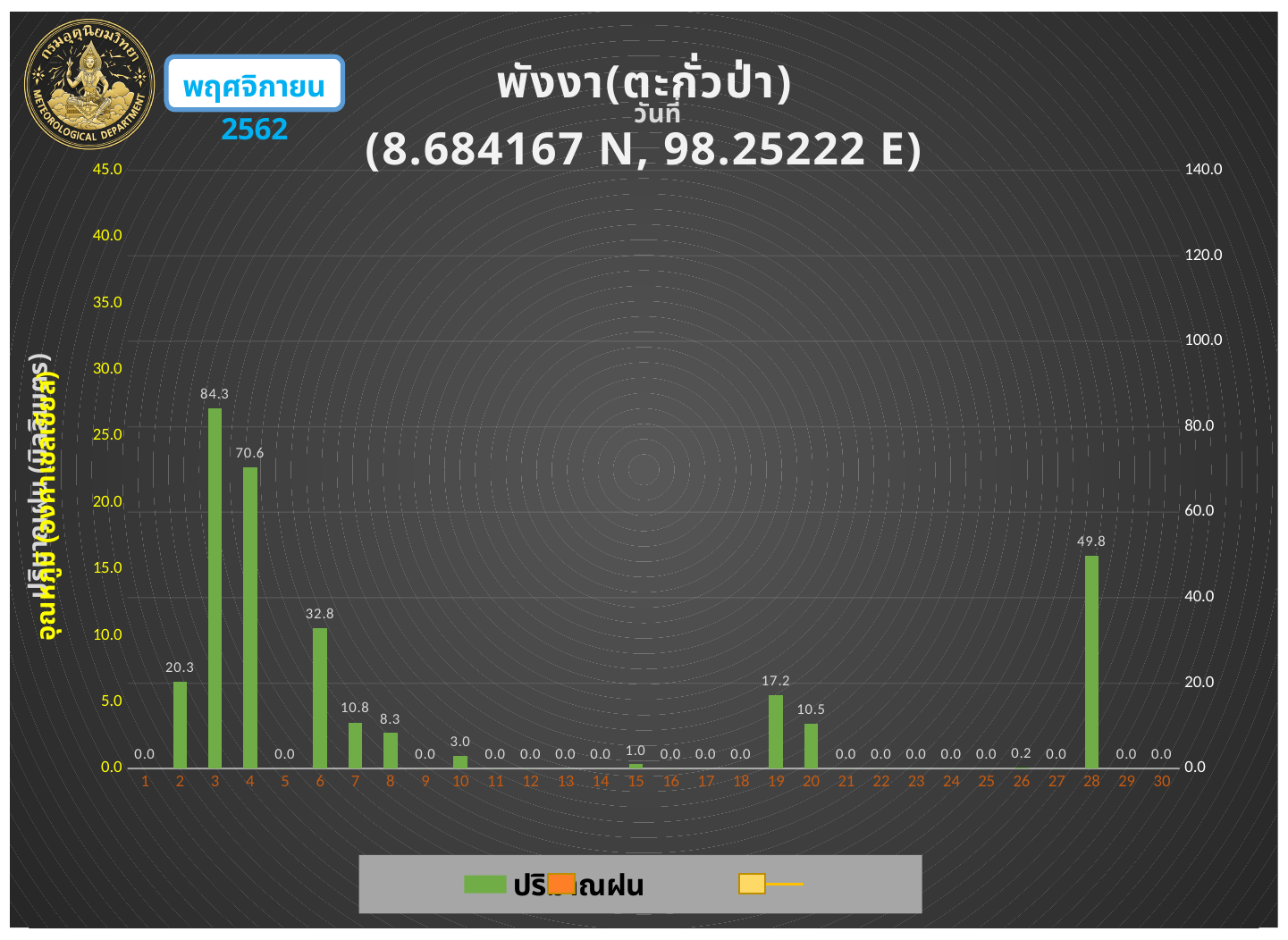
What is the value shown for day 26? 0.2 Which day has the highest value in the chart? 3 What is the value shown for day 3? 84.3 Which is larger, the value for day 19 or the value for day 20? day 19 What is the value shown for day 28? 49.8 What is the difference between the values for day 6 and day 7? 22.0 What is the difference between the values for day 3 and day 4? 13.7 What is the value shown for day 19? 17.2 What kind of chart is shown on the slide? bar chart Is the value for day 28 greater or less than 40.0 on the right axis? greater What are the coordinates given in the chart title? 8.684167 N, 98.25222 E How many days are shown on the x axis? 30